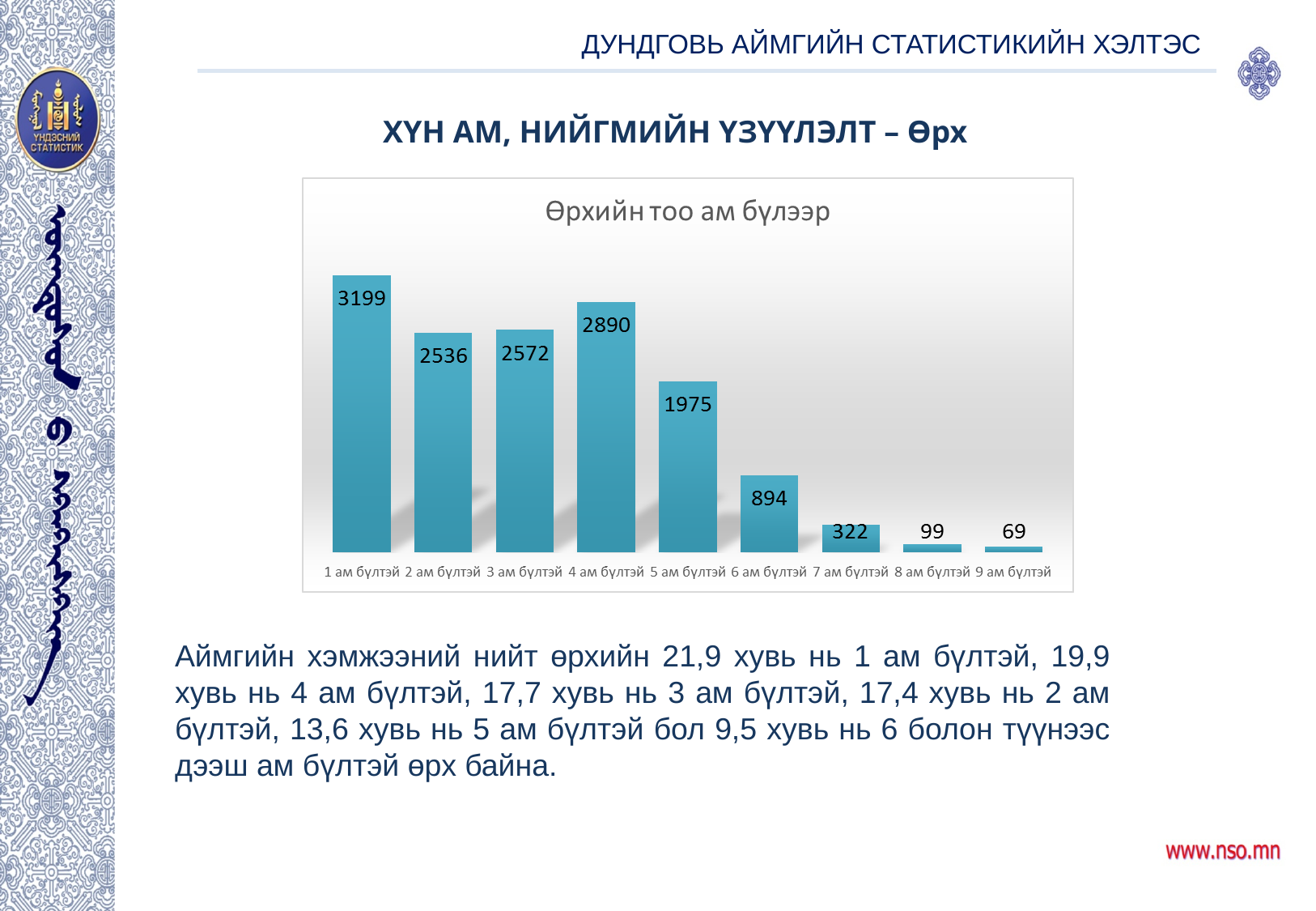
What is the value for 1 ам бүлтэй in the chart? 3199 What is the value for 6 ам бүлтэй in the chart? 894 What kind of chart is shown on the slide? Bar chart How many categories are shown in the chart? 9 What is the difference between the values for 1 ам бүлтэй and 2 ам бүлтэй? 663 Which category has the lowest value in the chart? 9 ам бүлтэй What is the title of the chart? Өрхийн тоо ам бүлээр Which is larger, the value for 3 ам бүлтэй or the value for 4 ам бүлтэй? 4 ам бүлтэй What is the difference between the values for 5 ам бүлтэй and 6 ам бүлтэй? 1081 What is the value for 4 ам бүлтэй in the chart? 2890 Which category has the highest value in the chart? 1 ам бүлтэй What is the value for 9 ам бүлтэй in the chart? 69